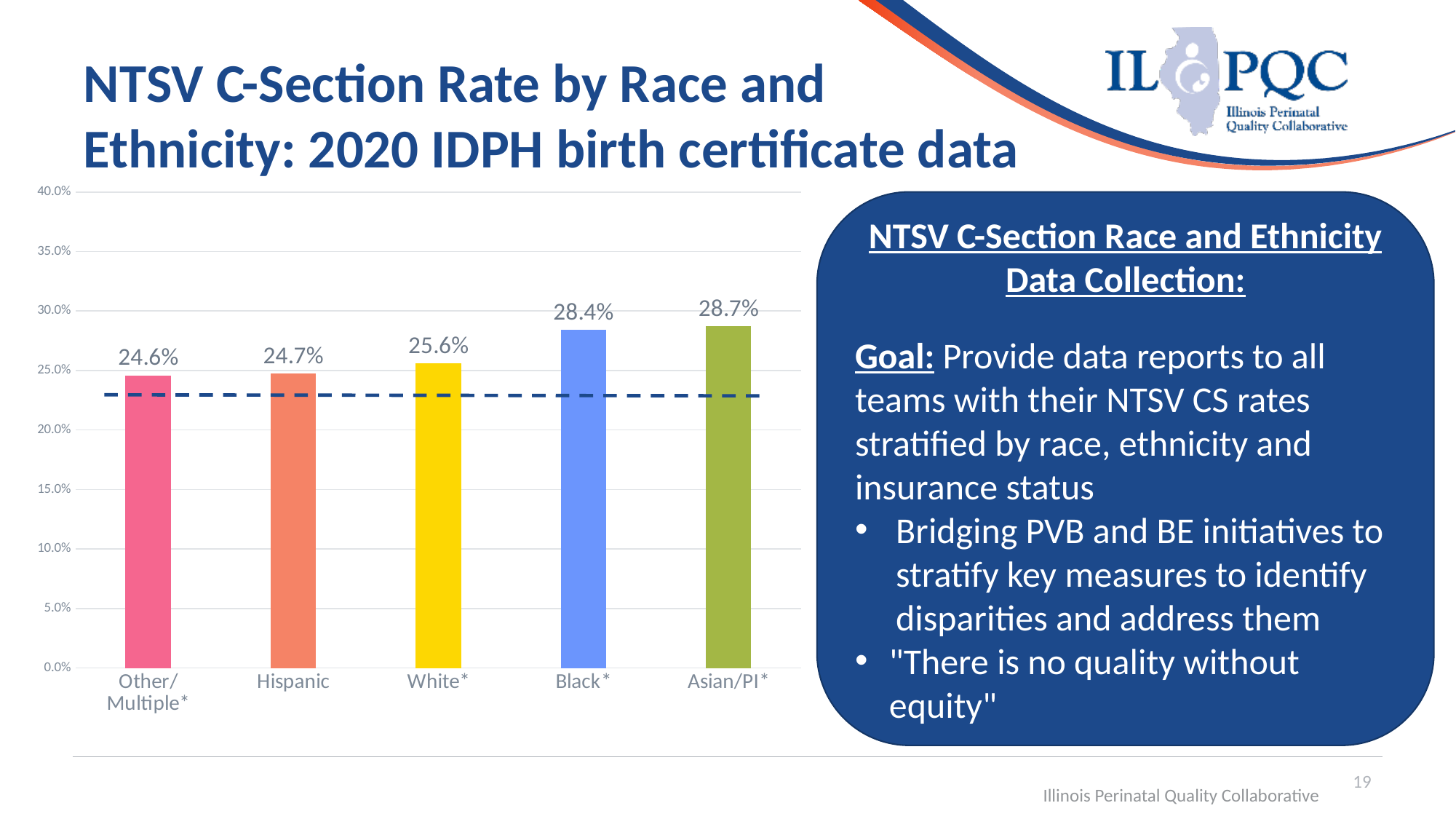
How many race/ethnicity categories are shown in the chart? 5 What is the NTSV C-section rate for Hispanic? 24.7% Which race/ethnicity category has the lowest NTSV C-section rate? Other/Multiple* Which race/ethnicity category has the highest NTSV C-section rate? Asian/PI* Which has a higher NTSV C-section rate, White* or Black*? Black* What is the NTSV C-section rate for Other/Multiple*? 24.6% What kind of chart is shown on the slide? Bar chart What is the difference between the NTSV C-section rates for Black* and Hispanic? 3.7% What is the NTSV C-section rate for Black*? 28.4% Is the value for Asian/PI* greater or less than 25.0%? greater What is the difference between the NTSV C-section rates for Asian/PI* and White*? 3.1% What colour is the bar for White*? Yellow